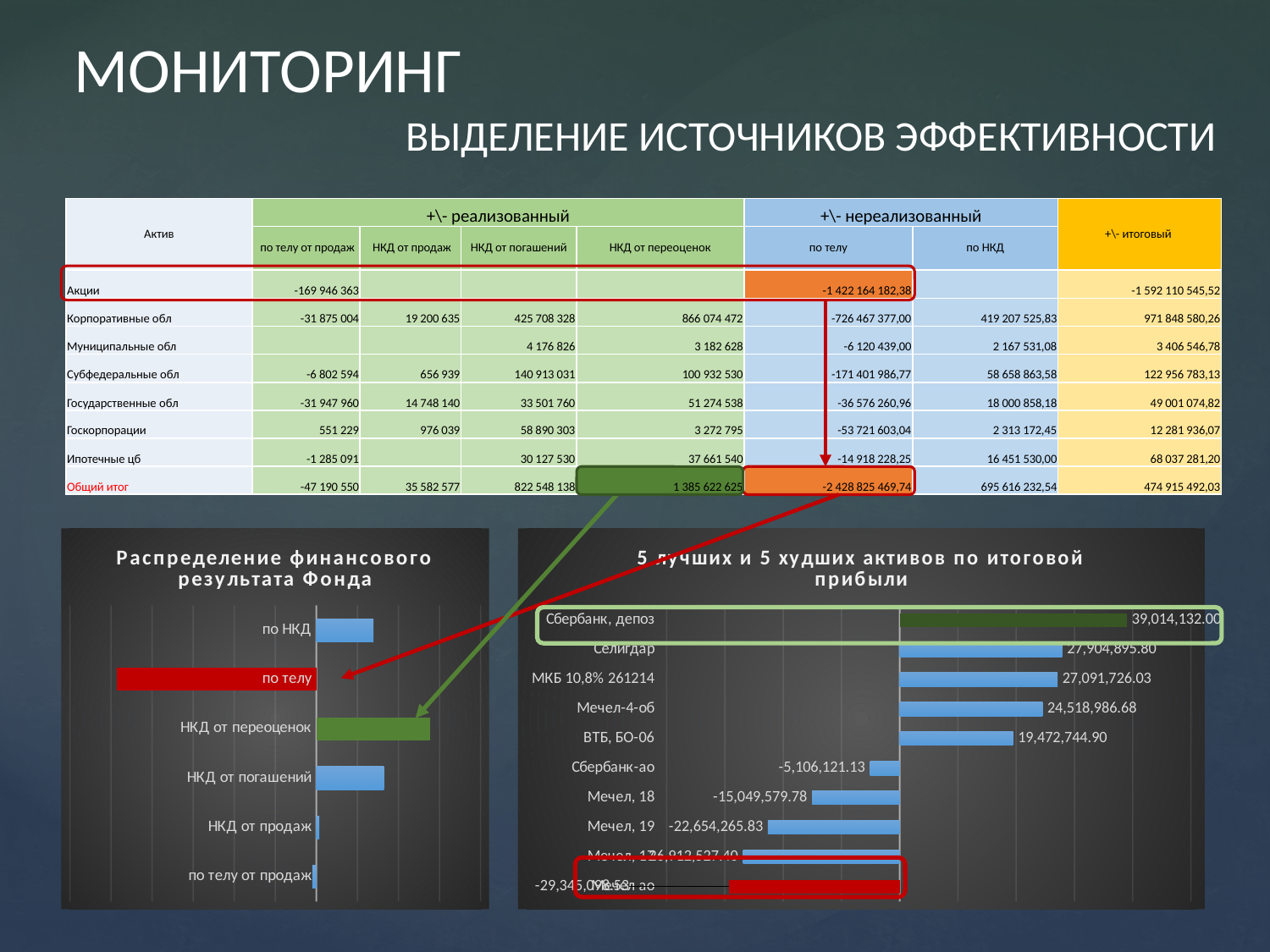
On the chart titled '5 лучших и 5 худших активов по итоговой прибыли', which asset has the highest value? Сбербанк, депоз On the chart titled '5 лучших и 5 худших активов по итоговой прибыли', what is the value for 'Селигдар'? 27,904,895.80 On the chart titled 'Распределение финансового результата Фонда', which category has the lowest value? по телу On the chart titled '5 лучших и 5 худших активов по итоговой прибыли', what is the difference between the values for 'Сбербанк, депоз' and 'ВТБ, БО-06'? 19,541,387.10 On the chart titled 'Распределение финансового результата Фонда', how many categories are shown? 6 On the chart titled 'Распределение финансового результата Фонда', which category has the highest value? НКД от переоценок On the chart titled '5 лучших и 5 худших активов по итоговой прибыли', how many assets (bars) are shown? 10 What kind of chart is the chart titled 'Распределение финансового результата Фонда'? Bar chart On the chart titled '5 лучших и 5 худших активов по итоговой прибыли', what is the value for 'ВТБ, БО-06'? 19,472,744.90 On the chart titled '5 лучших и 5 худших активов по итоговой прибыли', what is the value for 'Сбербанк, депоз'? 39,014,132.00 On the chart titled '5 лучших и 5 худших активов по итоговой прибыли', which is larger: the value for 'Мечел-4-об' or the value for 'МКБ 10,8% 261214'? МКБ 10,8% 261214 On the chart titled '5 лучших и 5 худших активов по итоговой прибыли', what is the value for 'Мечел, 18'? -15,049,579.78